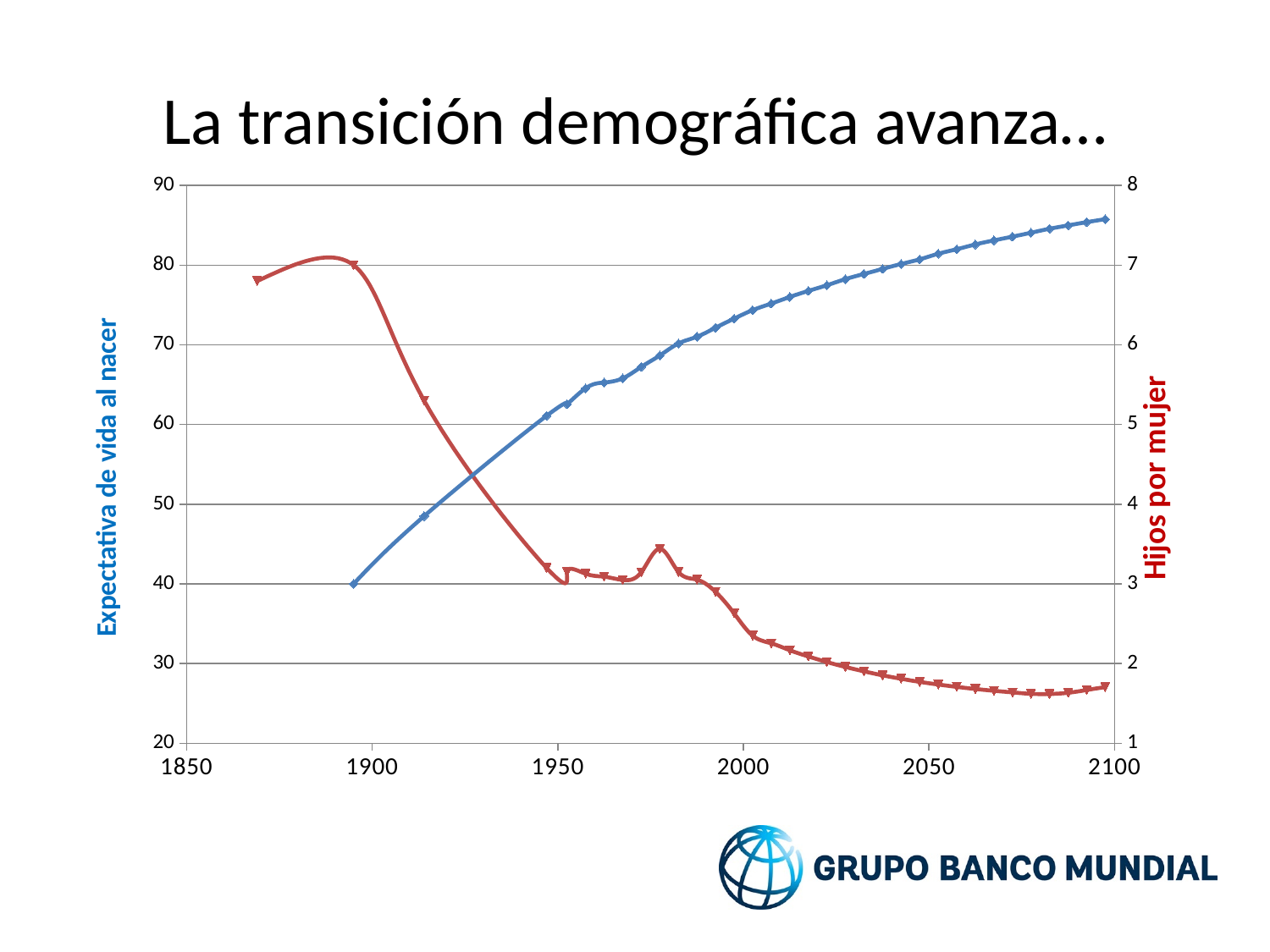
Does the 'Hijos por mujer' series rise or fall overall from 1900 to 2100? Fall Is the value of 'Hijos por mujer' in 2100 greater or less than 2? less Does the 'Expectativa de vida al nacer' series rise or fall from 1900 to 2100? Rise Is the value of 'Hijos por mujer' around 1900 greater or less than 6? greater What kind of chart is shown on the slide? Line chart What is the label of the left vertical axis? Expectativa de vida al nacer Is the value of 'Hijos por mujer' in 1950 greater or less than 4? less How many data series are plotted on the chart? 2 Which is larger for 'Hijos por mujer': the value around 1900 or the value in 2050? Around 1900 What is the title of the chart on the slide? La transición demográfica avanza…